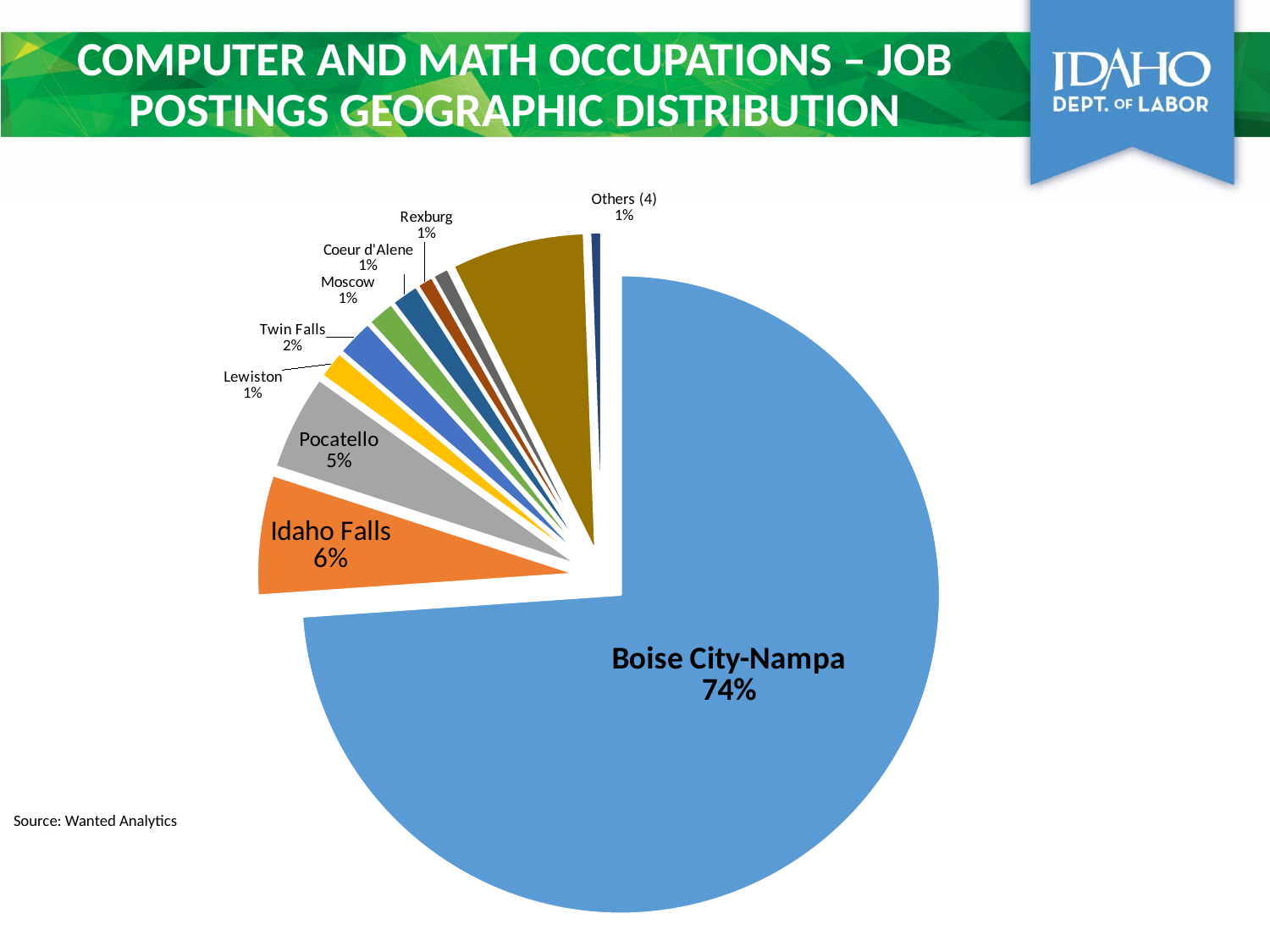
Which has a larger share, Idaho Falls or Pocatello? Idaho Falls What kind of chart is shown on the slide? pie chart What percentage is shown for Pocatello? 5% What percentage is shown for Idaho Falls? 6% What is the difference in percentage points between Idaho Falls and Pocatello? 1 percentage point What percentage is shown for the 'Others (4)' slice? 1% What share of job postings does Boise City-Nampa account for? 74% Which area has the largest share of job postings? Boise City-Nampa What is the title of the slide containing the chart? Computer and Math Occupations – Job Postings Geographic Distribution What source is cited for the chart data? Wanted Analytics What percentage is shown for Twin Falls? 2% What percentage is shown for Lewiston? 1%